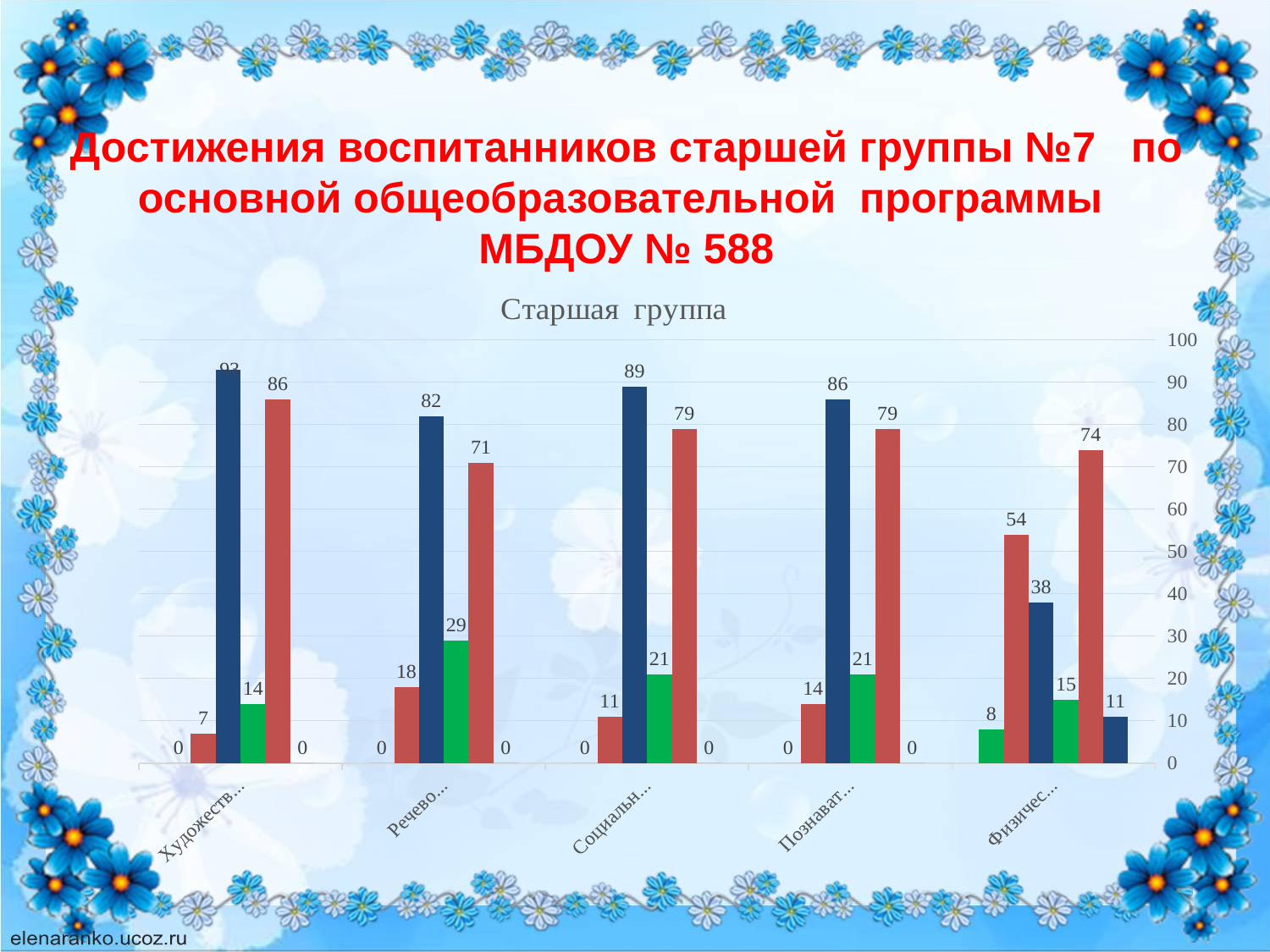
What is the title of the chart? Старшая группа What kind of chart is shown on the slide? bar chart In the Познават... category, what is the difference between the tallest bar (86) and the bar labelled 79? 7 Which is larger: the tallest bar in Речево... or the tallest bar in Социальн...? Социальн... What is the value of the tallest bar in the Социальн... category? 89 Is the tallest bar in the Физичес... category greater or less than 70? greater What is the smallest non-zero value labelled in the Физичес... category? 8 What is the value of the green bar in the Социальн... category? 21 Which category has the highest green bar? Речево... What is the value of the tallest bar in the Речево... category? 82 How many categories are shown along the x axis of the chart? 5 What is the value of the green bar in the Речево... category? 29